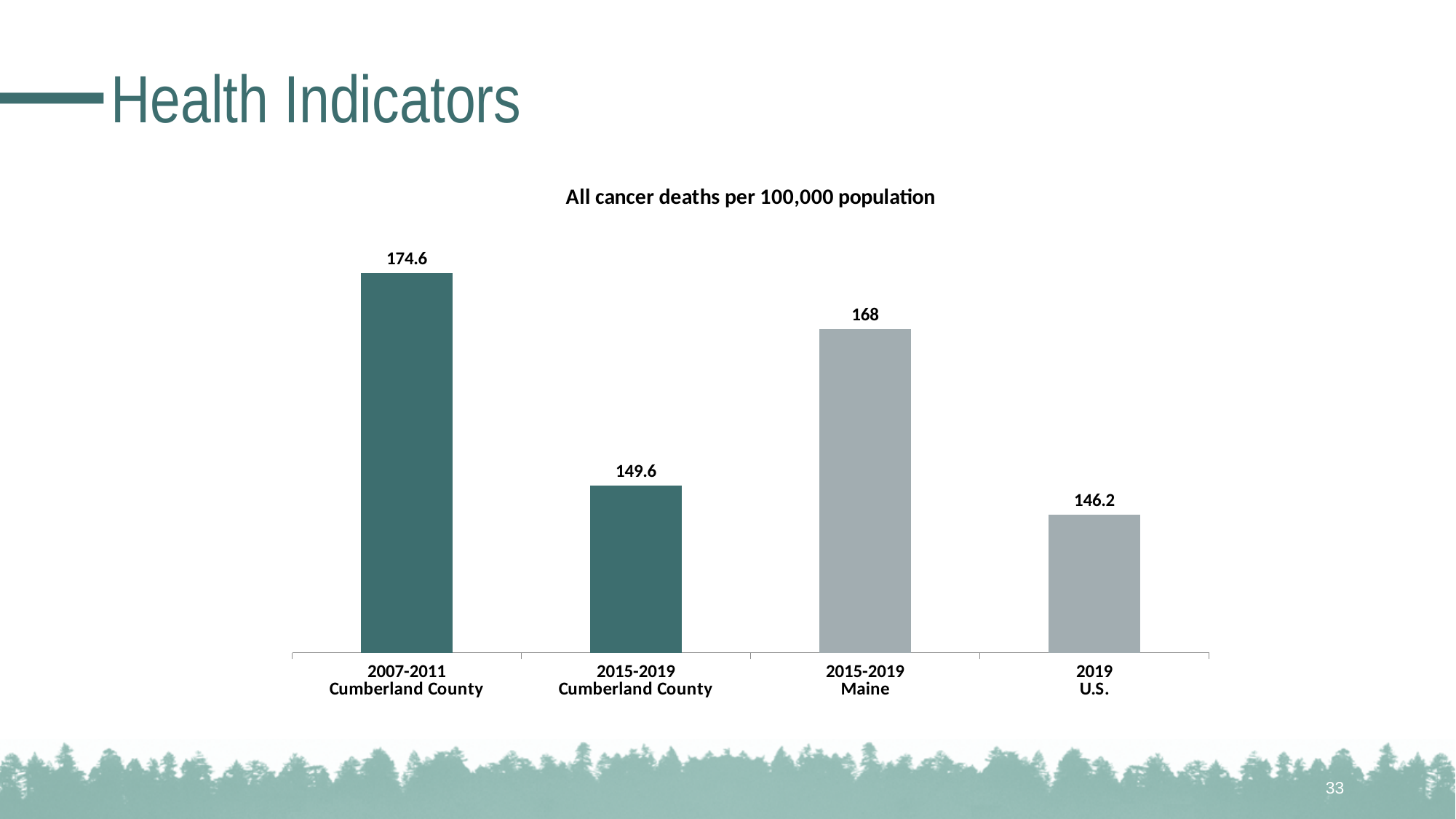
What is the value for 2015-2019 Cumberland County? 149.6 Which category has the lowest value? 2019 U.S. Which category has the highest value? 2007-2011 Cumberland County What is the value for 2015-2019 Maine? 168 What is the difference between the 2007-2011 Cumberland County value and the 2015-2019 Cumberland County value? 25 Which is larger, the value for 2015-2019 Maine or the value for 2015-2019 Cumberland County? 2015-2019 Maine What is the value for 2019 U.S.? 146.2 What is the value for 2007-2011 Cumberland County? 174.6 How many categories are shown in the chart? 4 What is the title of the chart? All cancer deaths per 100,000 population What kind of chart is shown on the slide? Bar chart What is the difference between the 2015-2019 Maine value and the 2019 U.S. value? 21.8